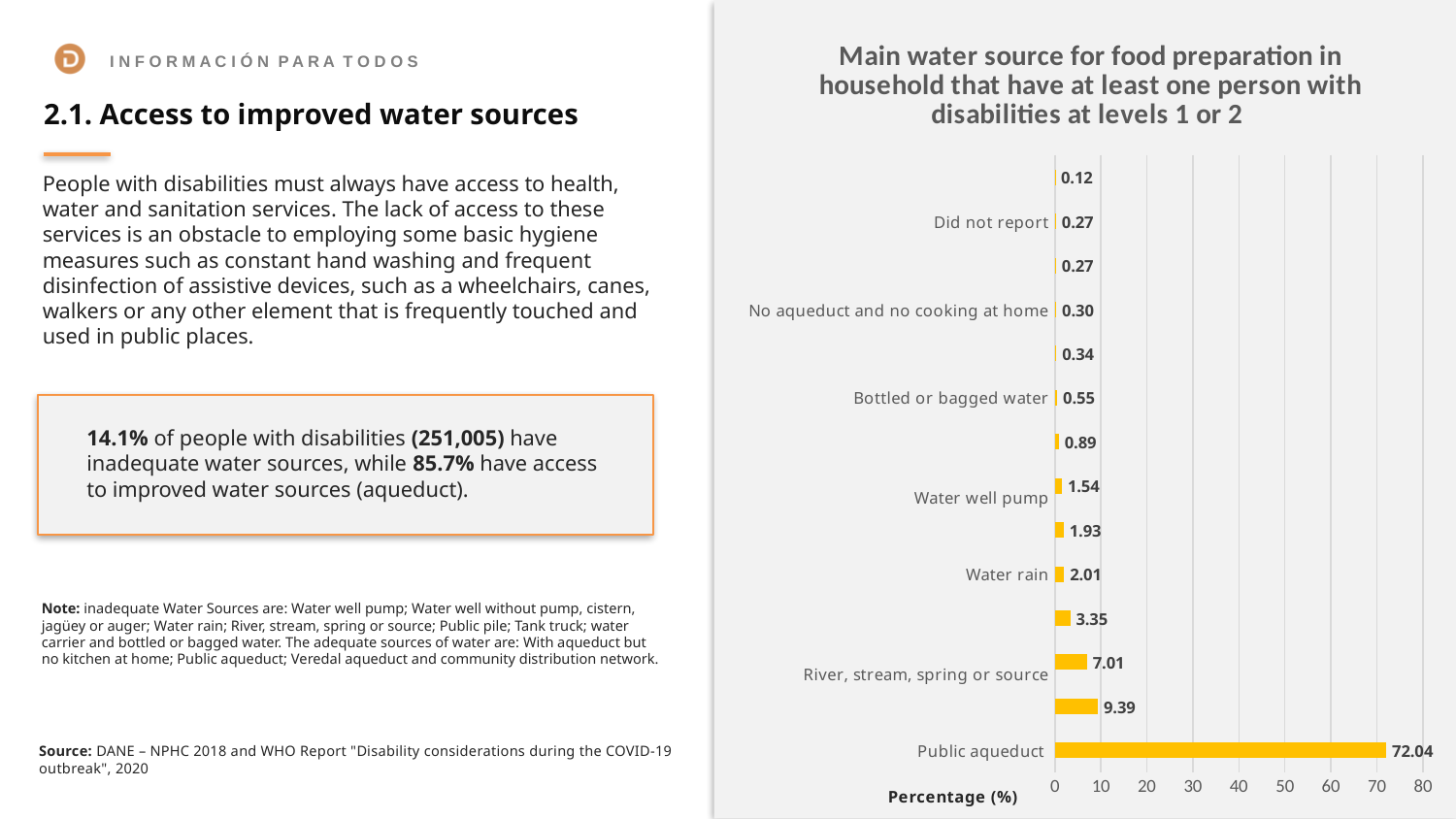
What is the smallest value labeled on the chart? 0.12 What is the value for Public aqueduct? 72.04 Which category has the highest value? Public aqueduct Which is larger, the value for Water rain or the value for Water well pump? Water rain What is the value for Water rain? 2.01 What type of chart is shown on the slide? Bar chart What is the value for River, stream, spring or source? 7.01 Is the value for Public aqueduct greater or less than 70? greater What is the difference between the values for Public aqueduct and River, stream, spring or source? 65.03 What is the value for Bottled or bagged water? 0.55 What is the value for Water well pump? 1.54 What is the title of the horizontal axis? Percentage (%)